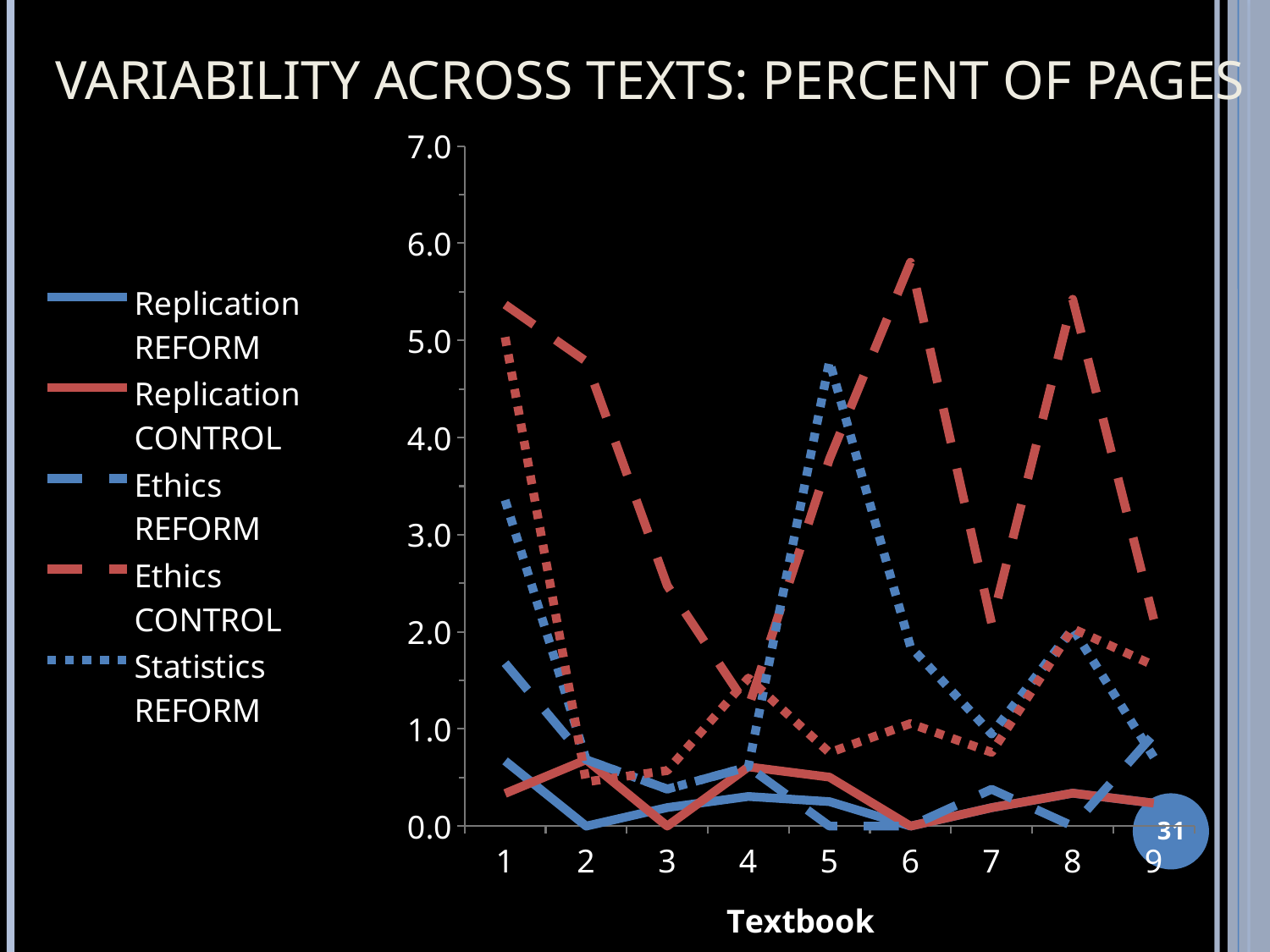
How many series does the legend list? 5 What is the title of the x axis? Textbook At which textbook does Ethics CONTROL reach its highest value? 6 Does the Ethics CONTROL line rise or fall from textbook 1 to textbook 4? fall What kind of chart is shown on the slide? line chart Is the value for Ethics CONTROL at textbook 6 greater or less than 5.0? greater Is the value for Statistics REFORM at textbook 5 greater or less than 4.0? greater Is the value for Statistics REFORM at textbook 1 greater or less than 3.0? greater At which textbook does Statistics REFORM reach its highest value? 5 How many textbooks are plotted along the x axis? 9 At textbook 1, which is larger: Ethics CONTROL or Statistics REFORM? Ethics CONTROL